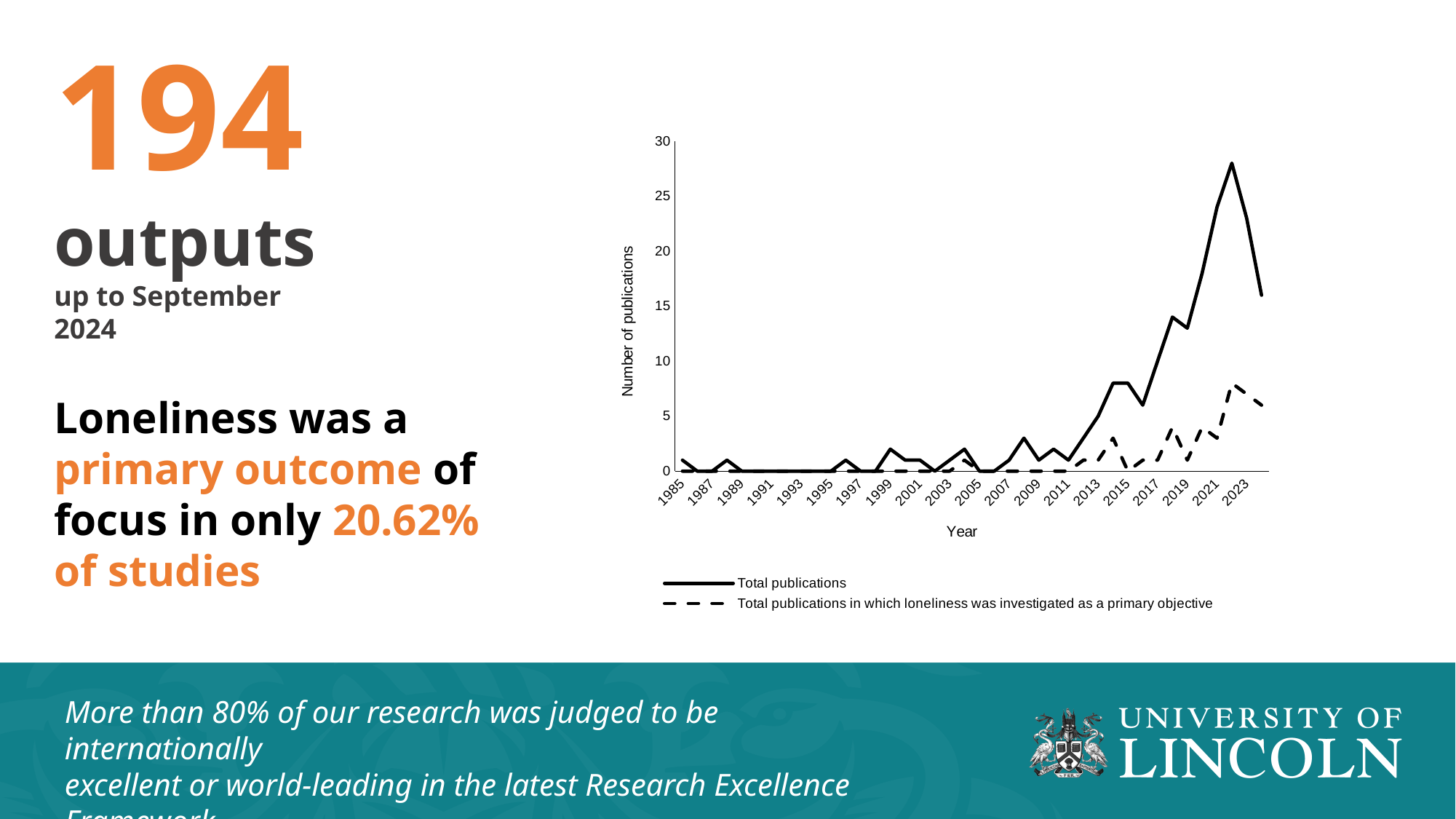
Is the value for Total publications in which loneliness was investigated as a primary objective in 2023 greater or less than 10? less In 2023, which series has the higher value: Total publications or Total publications in which loneliness was investigated as a primary objective? Total publications Is the peak value of the Total publications series greater or less than 25? greater How many year labels are shown on the x axis? 20 Is the value for Total publications in 2015 greater or less than 5? greater How many series does the chart's legend list? 2 What is the label of the y axis of the chart? Number of publications What kind of chart is shown on the slide? line chart Overall, do the Total publications values rise or fall from 1985 to the early 2020s? rise Which series is drawn with a dashed line? Total publications in which loneliness was investigated as a primary objective What is the label of the x axis of the chart? Year